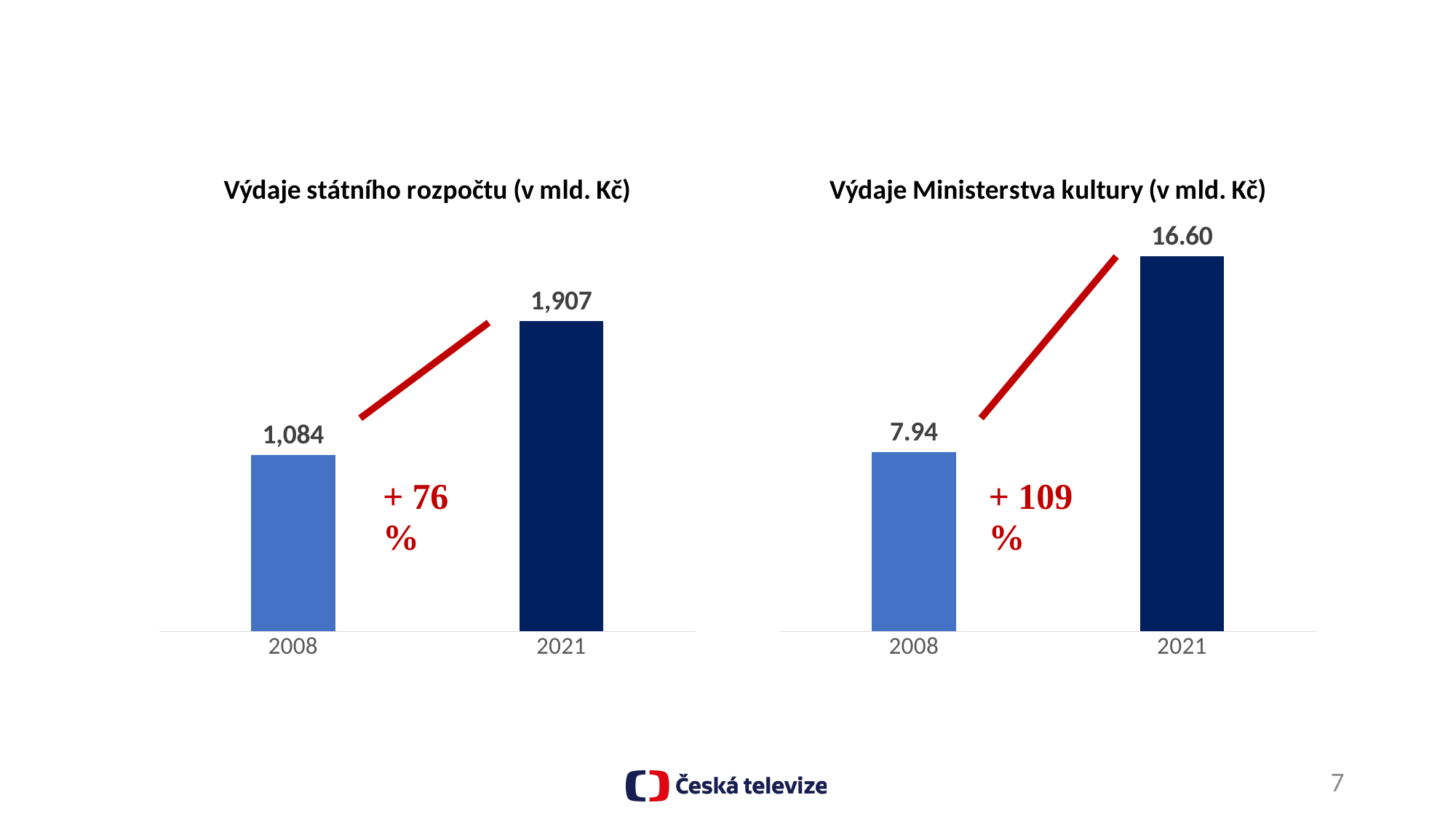
In the chart titled 'Výdaje Ministerstva kultury (v mld. Kč)', what is the value for 2008? 7.94 In the chart titled 'Výdaje státního rozpočtu (v mld. Kč)', what is the value for 2008? 1,084 In the chart titled 'Výdaje Ministerstva kultury (v mld. Kč)', what is the value for 2021? 16.60 In the chart titled 'Výdaje státního rozpočtu (v mld. Kč)', what is the value for 2021? 1,907 What kind of chart is the chart titled 'Výdaje Ministerstva kultury (v mld. Kč)'? bar chart In the chart titled 'Výdaje státního rozpočtu (v mld. Kč)', what is the difference between the 2021 and 2008 values? 823 In the chart titled 'Výdaje státního rozpočtu (v mld. Kč)', which year has the higher value? 2021 In the chart titled 'Výdaje Ministerstva kultury (v mld. Kč)', what is the difference between the 2021 and 2008 values? 8.66 In the chart titled 'Výdaje Ministerstva kultury (v mld. Kč)', is the value for 2021 larger or smaller than the value for 2008? larger What percentage increase is annotated in red on the chart titled 'Výdaje Ministerstva kultury (v mld. Kč)'? + 109 % In the chart titled 'Výdaje Ministerstva kultury (v mld. Kč)', which year has the lower value? 2008 How many bars are shown in the chart titled 'Výdaje státního rozpočtu (v mld. Kč)'? 2